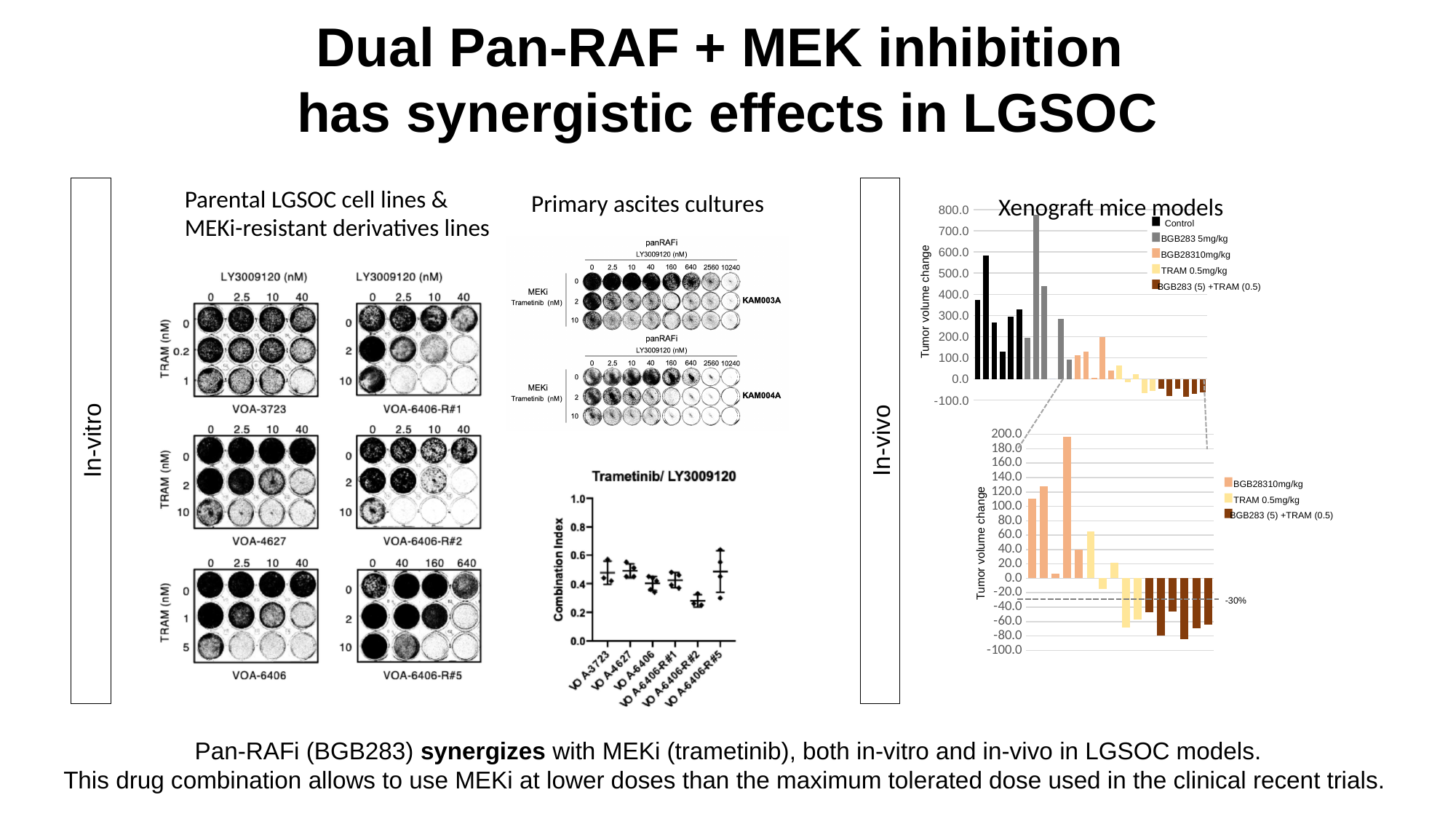
In the zoomed-in tumor volume change chart (bottom right), how many series does the legend list? 3 In the Xenograft mice models chart (top right), is the tallest bar greater or less than 700.0? greater In the Xenograft mice models chart (top right), what is the y-axis label? Tumor volume change In the Trametinib/ LY3009120 Combination Index chart, which cell line has the lowest combination index? VOA-6406-R#2 In the Xenograft mice models chart (top right), which series does the tallest bar belong to? BGB283 5mg/kg In the Xenograft mice models chart (top right), what kind of chart is shown? bar chart In the Trametinib/ LY3009120 Combination Index chart, how many cell lines are plotted on the x axis? 6 In the Trametinib/ LY3009120 Combination Index chart, is the mean combination index for VOA-6406-R#2 greater or less than 0.4? less In the zoomed-in tumor volume change chart (bottom right), what value is labelled on the dashed horizontal line? -30% In the Xenograft mice models chart (top right), how many series does the legend list? 5 In the zoomed-in tumor volume change chart (bottom right), is the tallest bar greater or less than 180.0? greater In the zoomed-in tumor volume change chart (bottom right), which series does the tallest bar belong to? BGB28310mg/kg